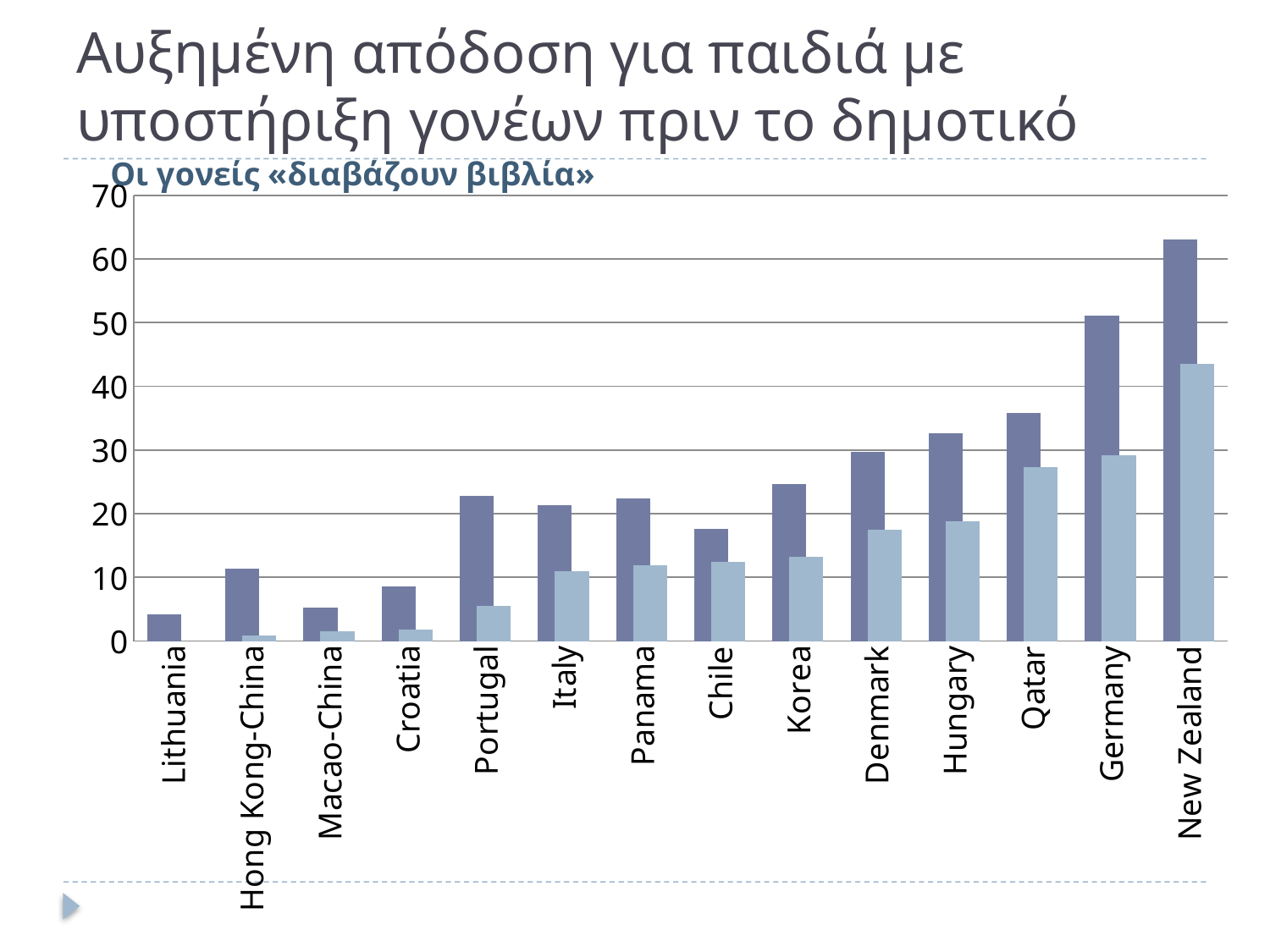
Which is larger, the dark blue bar for Germany or the dark blue bar for Qatar? Germany Which country has the lowest dark blue bar? Lithuania Is the dark blue bar for New Zealand greater or less than 60? greater How many series (bar colours) are plotted for each country? 2 Is the dark blue bar for Qatar greater or less than 30? greater Is the dark blue bar for Lithuania greater or less than 10? less What is the title of the chart? Οι γονείς «διαβάζουν βιβλία» What kind of chart is shown on the slide? bar chart Which country has the highest dark blue bar? New Zealand How many countries are shown on the x axis of the chart? 14 Do the dark blue bars generally rise or fall from left to right along the x axis? rise